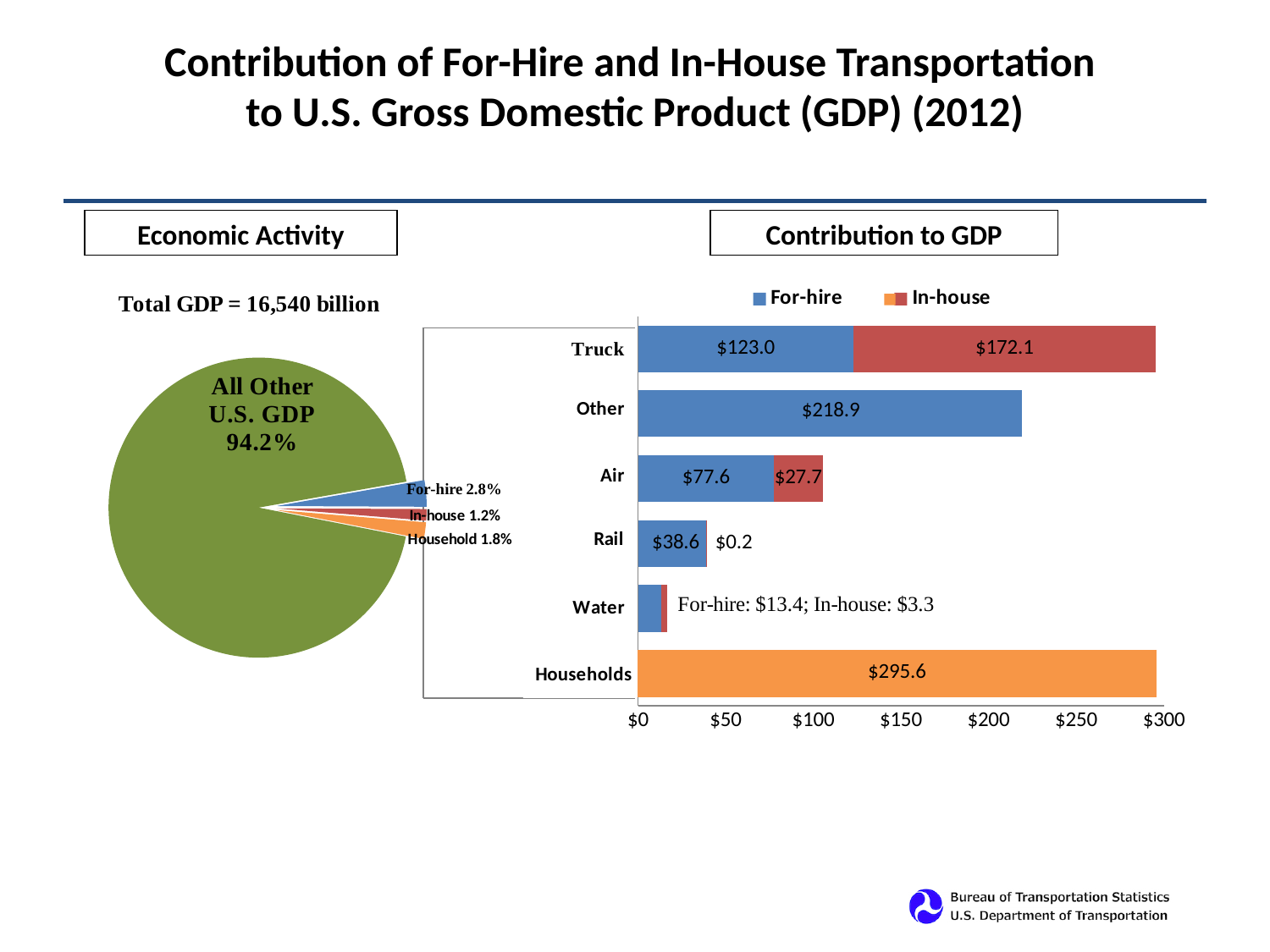
In the Contribution to GDP bar chart, what is the difference between the For-hire values for Other and Air? $141.3 In the Contribution to GDP bar chart, which category has the largest For-hire value? Other How many series does the legend of the Contribution to GDP bar chart list? 2 In the Economic Activity pie chart, what share is labelled Household? 1.8% In the Contribution to GDP bar chart, what is the In-house value for Air? $27.7 In the Contribution to GDP bar chart, what is the In-house value for Water? $3.3 In the Contribution to GDP bar chart, what is the value shown for Households? $295.6 In the Contribution to GDP bar chart, which is larger: the For-hire value for Rail or the In-house value for Air? For-hire value for Rail In the Contribution to GDP bar chart, which category has the smallest For-hire value? Water In the Contribution to GDP bar chart, what is the For-hire value for Truck? $123.0 In the Economic Activity pie chart, what share of GDP is labelled All Other U.S. GDP? 94.2% In the Contribution to GDP bar chart, what is the total of the Truck bar (For-hire plus In-house)? $295.1